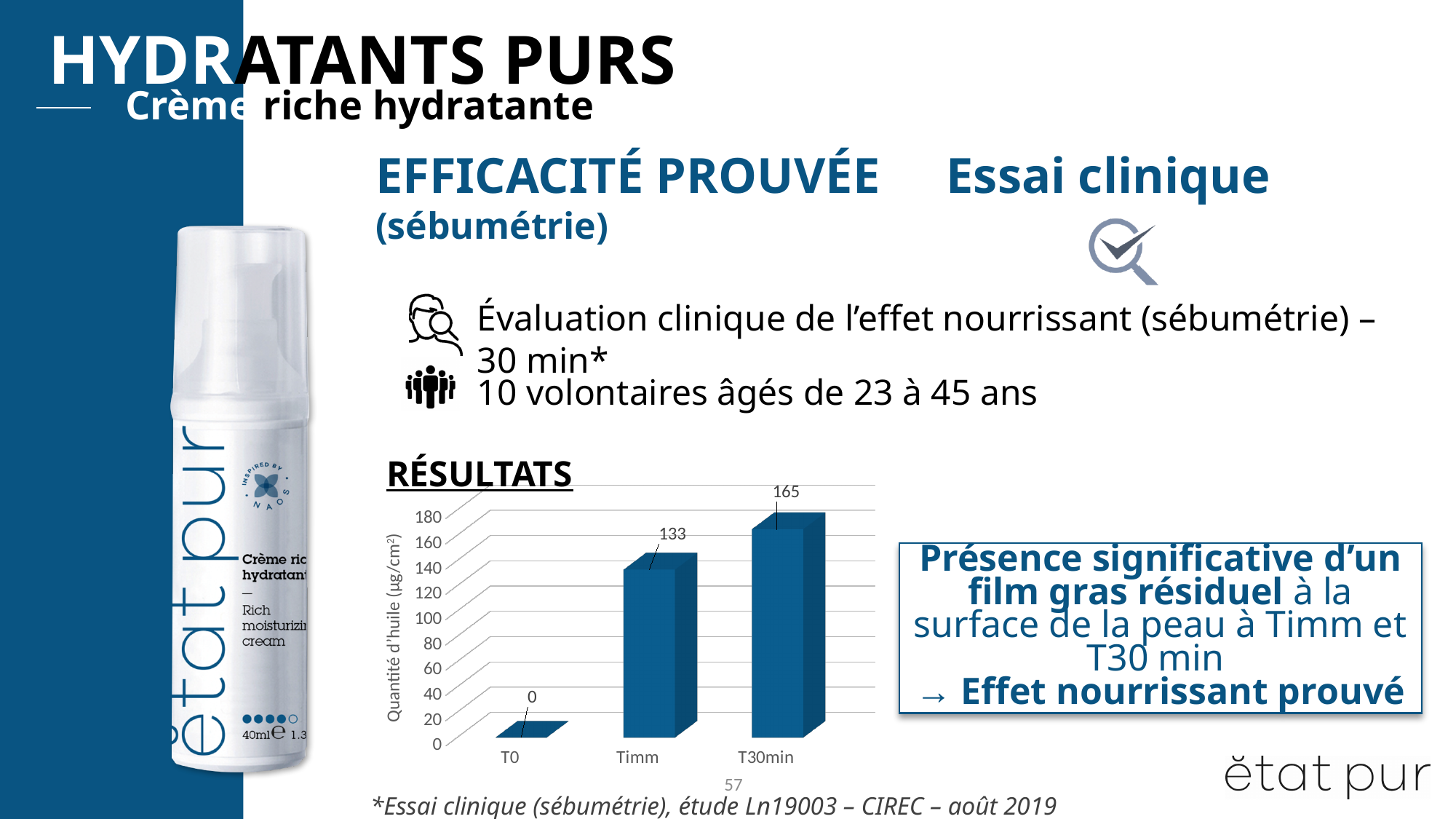
What is the difference between the values for Timm and T0? 133 Do the values rise or fall from T0 to T30min? rise What kind of chart is shown? bar chart Is the value for Timm greater or less than 120? greater Which category has the lowest value? T0 Which is larger, the value for Timm or the value for T30min? T30min What is the difference between the values for T30min and Timm? 32 What is the value for Timm? 133 Which category has the highest value? T30min How many categories are shown on the x axis? 3 What is the value for T0? 0 What is the value for T30min? 165